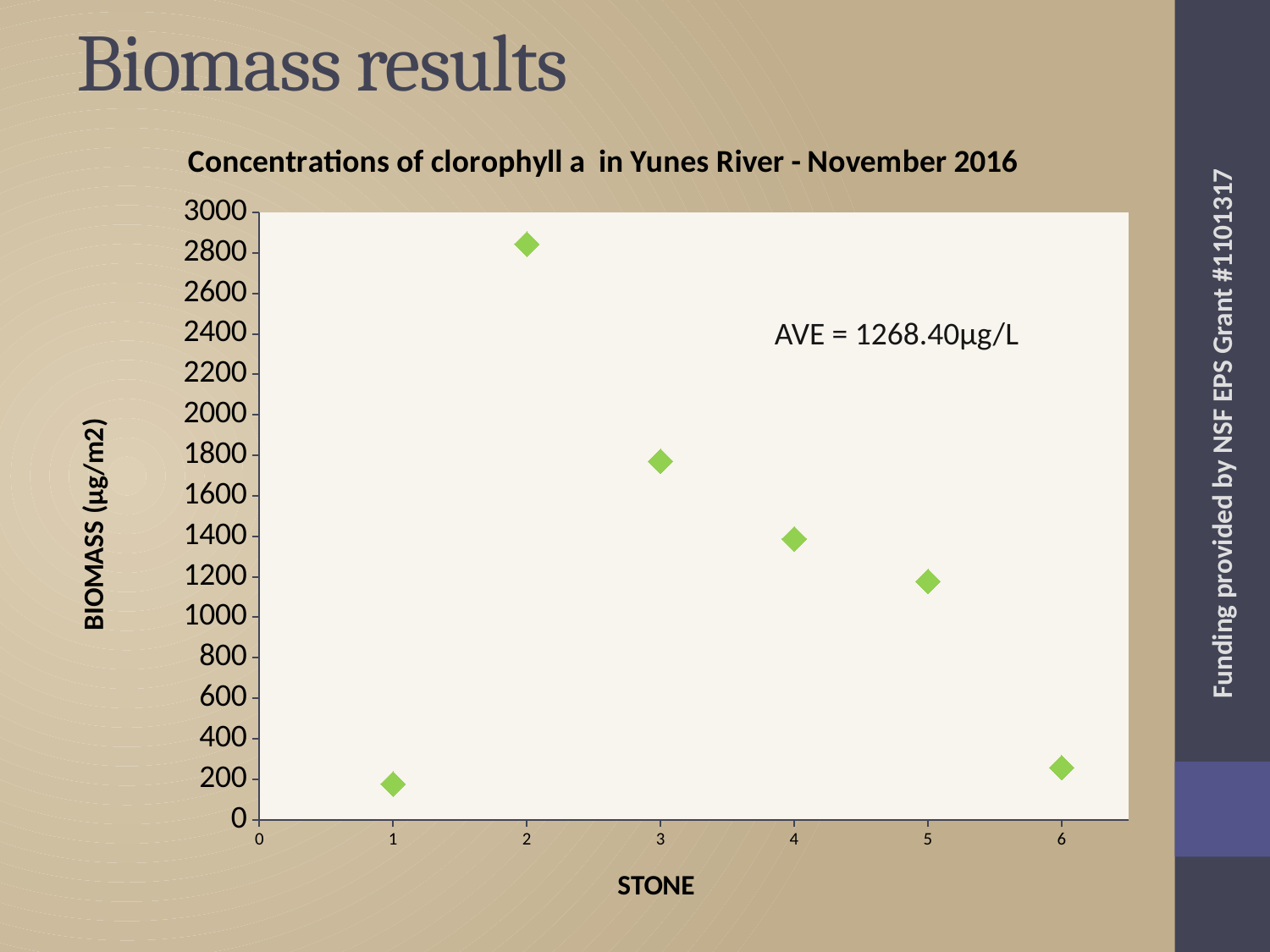
What average value is printed on the chart? AVE = 1268.40µg/L Is the biomass value for stone 6 greater or less than 200? greater What is the title of the chart? Concentrations of clorophyll a in Yunes River - November 2016 How many stones (data points) are plotted in the chart? 6 Which stone has the lowest biomass value? Stone 1 Which stone has the highest biomass value? Stone 2 Do the biomass values rise or fall from stone 2 to stone 5? fall What kind of chart is shown on the slide? scatter chart Is the biomass value for stone 2 greater or less than 2800? greater Which has a larger biomass value, stone 3 or stone 5? Stone 3